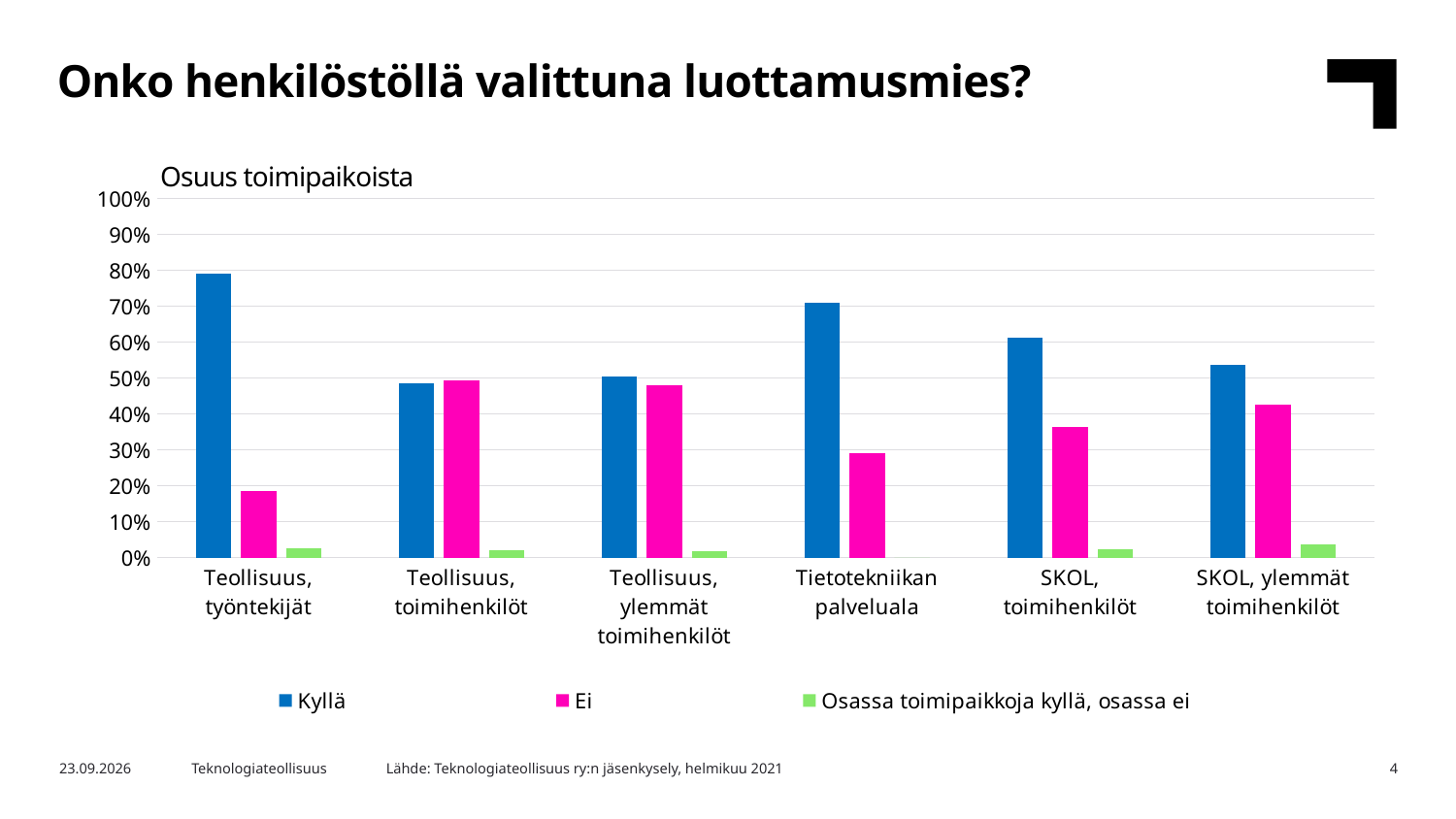
How many categories are shown on the x axis of the chart? 6 What kind of chart is shown on the slide? Bar chart For SKOL, toimihenkilöt, which is larger: the Kyllä value or the Ei value? Kyllä Which category has the lowest value for the Ei series? Teollisuus, työntekijät Is the Kyllä value for Teollisuus, työntekijät greater or less than 70%? greater Is the Ei value for SKOL, ylemmät toimihenkilöt greater or less than 30%? greater Which category has the highest value for the Kyllä series? Teollisuus, työntekijät Is the Ei value for Tietotekniikan palveluala greater or less than 40%? less For Tietotekniikan palveluala, which is larger: the Kyllä value or the Ei value? Kyllä What is the title shown above the chart's vertical axis? Osuus toimipaikoista How many series does the chart's legend list? 3